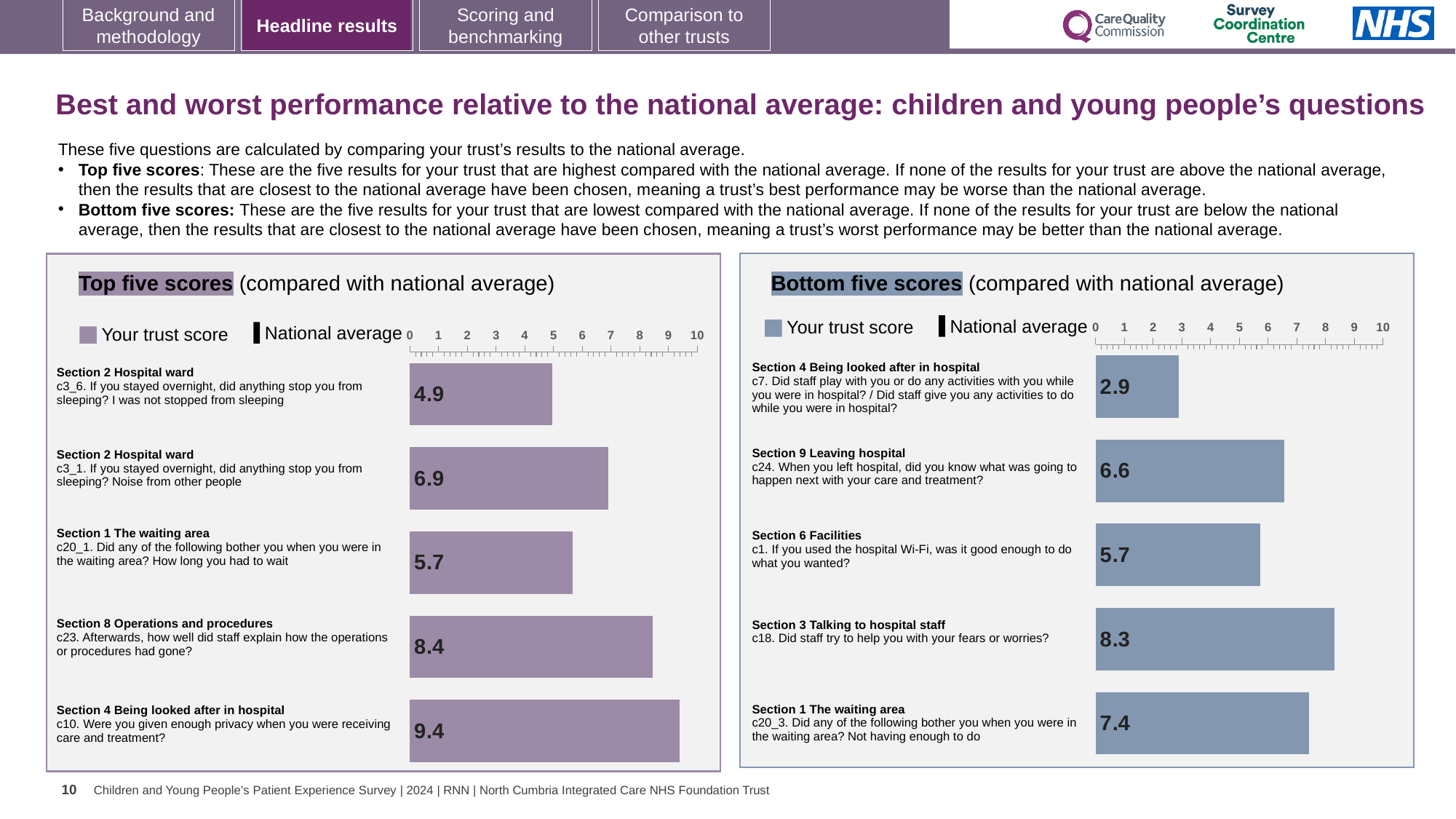
In the Bottom five scores chart, which question has the lowest trust score? c7. Did staff play with you or do any activities with you while you were in hospital? (2.9) What kind of chart is the Bottom five scores chart? Bar chart In the Bottom five scores chart, which has the larger trust score: c24 'did you know what was going to happen next' or c1 'hospital Wi-Fi'? c24 (6.6) How many bars are shown in the Top five scores chart? 5 In the Top five scores chart, is the trust score for c23 'how well did staff explain how the operations or procedures had gone' greater or less than 8? greater In the Bottom five scores chart, what is the trust score for c7 'Did staff play with you or do any activities with you while you were in hospital?' 2.9 In the Top five scores chart, which question has the highest trust score? c10. Were you given enough privacy when you were receiving care and treatment? (9.4) In the Top five scores chart, what is the difference between the trust score for c10 (privacy) and c3_6 (not stopped from sleeping)? 4.5 In the Top five scores chart, what is the trust score for c10 'Were you given enough privacy when you were receiving care and treatment?' 9.4 In the Bottom five scores chart, what is the difference between the trust score for c18 (fears or worries) and c20_3 (not having enough to do)? 0.9 In the Bottom five scores chart, what is the trust score for c18 'Did staff try to help you with your fears or worries?' 8.3 What two entries does the legend of the Top five scores chart list? Your trust score; National average